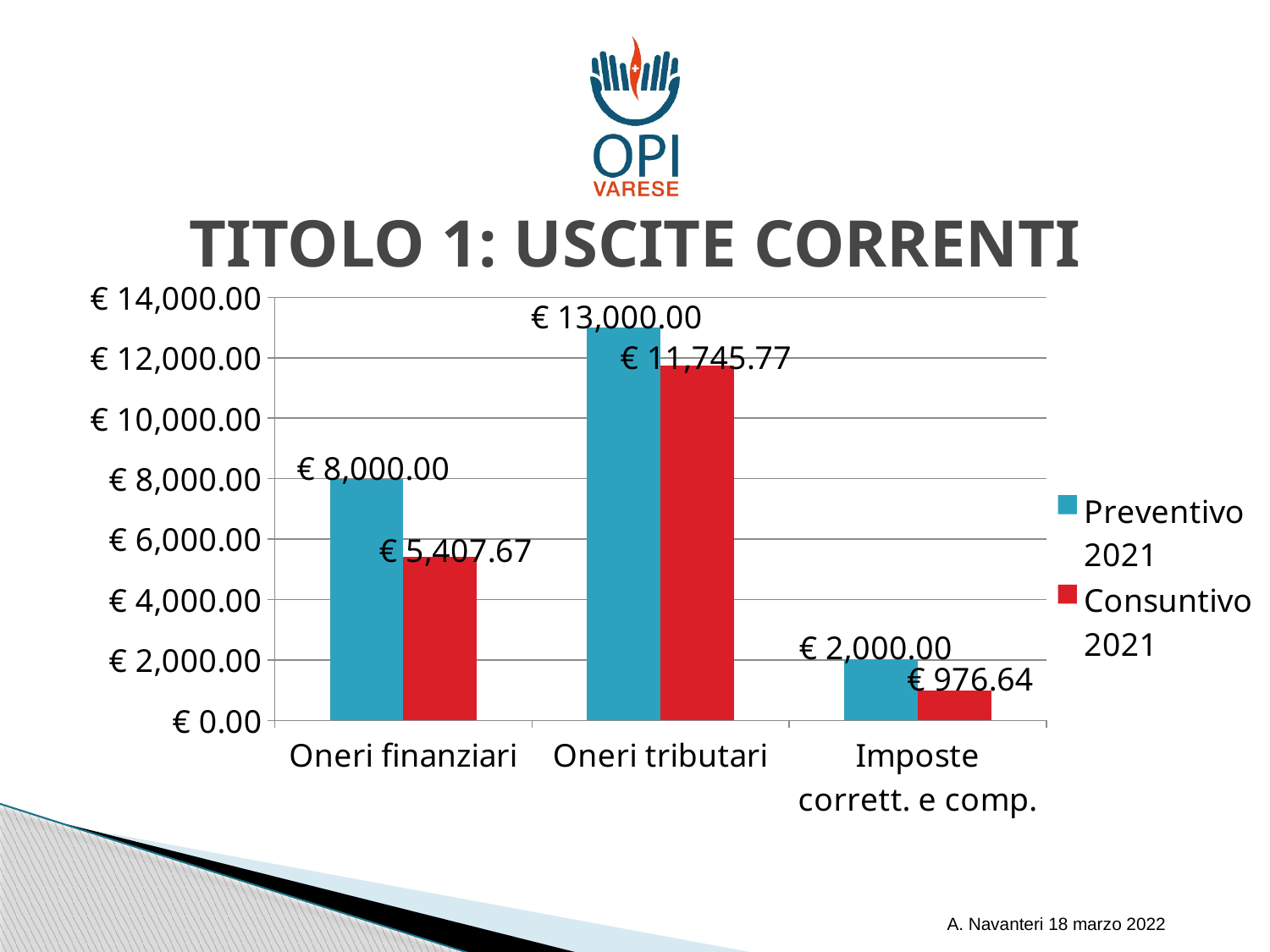
Which category has the lowest Consuntivo 2021 value? Imposte corrett. e comp. Which is larger for Oneri tributari: the Preventivo 2021 value or the Consuntivo 2021 value? Preventivo 2021 Which category has the highest Preventivo 2021 value? Oneri tributari What is the title of the chart? TITOLO 1: USCITE CORRENTI How many series does the legend list? 2 What is the Preventivo 2021 value for Oneri finanziari? € 8,000.00 What is the Consuntivo 2021 value for Oneri tributari? € 11,745.77 How many categories are shown on the x axis? 3 Is the Consuntivo 2021 value for Oneri finanziari greater or less than € 6,000.00? less What is the Consuntivo 2021 value for Imposte corrett. e comp.? € 976.64 What is the difference between the Preventivo 2021 and Consuntivo 2021 values for Oneri finanziari? € 2,592.33 What kind of chart is shown on the slide? bar chart